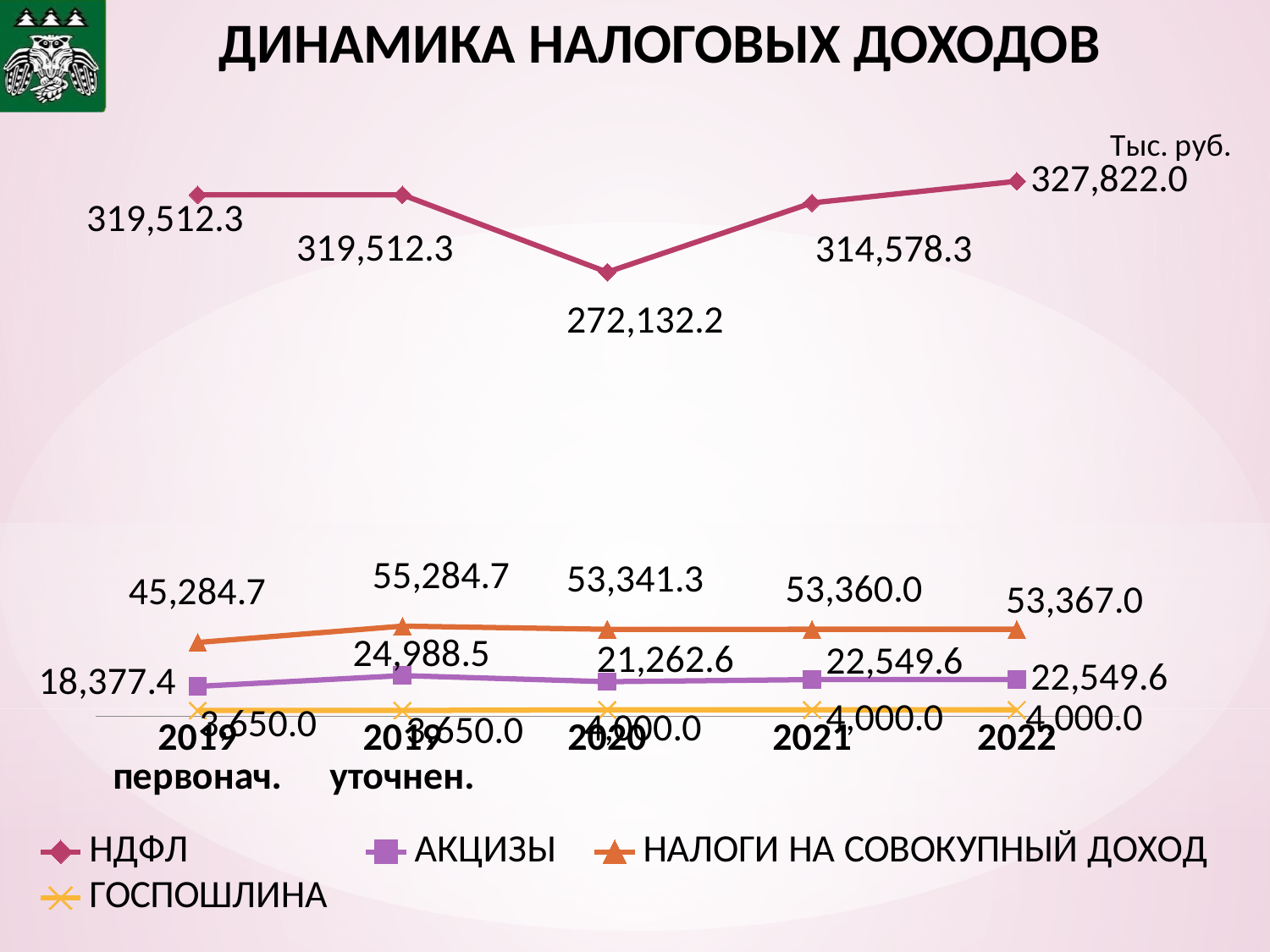
What is the value of НАЛОГИ НА СОВОКУПНЫЙ ДОХОД for 2019 первонач.? 45,284.7 In which category is the НАЛОГИ НА СОВОКУПНЫЙ ДОХОД value highest? 2019 уточнен. What is the value of НДФЛ for 2022? 327,822.0 What is the value of ГОСПОШЛИНА for 2021? 4,000.0 What is the value of АКЦИЗЫ for 2019 уточнен.? 24,988.5 What type of chart is shown on the slide? Line chart Which is larger, the АКЦИЗЫ value for 2019 уточнен. or for 2020? 2019 уточнен. How many series does the legend list? 4 What is the value of НДФЛ for 2020? 272,132.2 What is the difference between the НДФЛ values for 2022 and 2021? 13,243.7 In which year is the НДФЛ value lowest? 2020 How many categories are shown on the x axis? 5